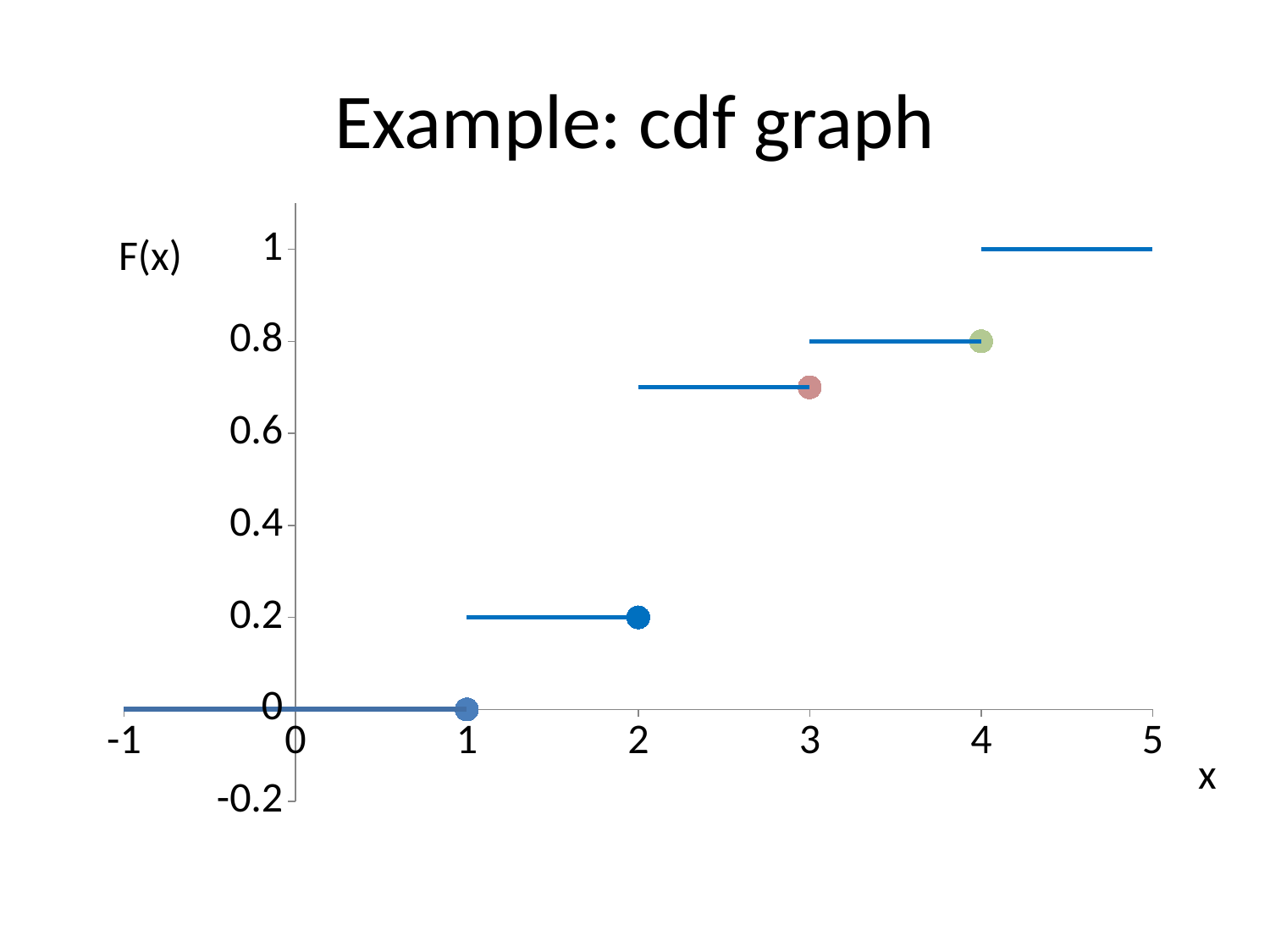
Over which interval of x does F(x) reach its highest value? between 4 and 5 What is the value of F(x) for x between 3 and 4? 0.8 What label is shown on the vertical axis? F(x) Is the value of F(x) for x between 2 and 3 greater or less than 0.8? less What is the title of the chart? Example: cdf graph What is the value of F(x) for x between 1 and 2? 0.2 What kind of chart is shown on the slide? line chart What is the difference between the value of F(x) for x between 3 and 4 and the value for x between 1 and 2? 0.6 What is the value of F(x) for x between -1 and 1? 0 Is the value of F(x) for x between 2 and 3 greater or less than 0.6? greater Does F(x) rise or fall as x increases along the x axis? rises What is the value of F(x) for x between 4 and 5? 1